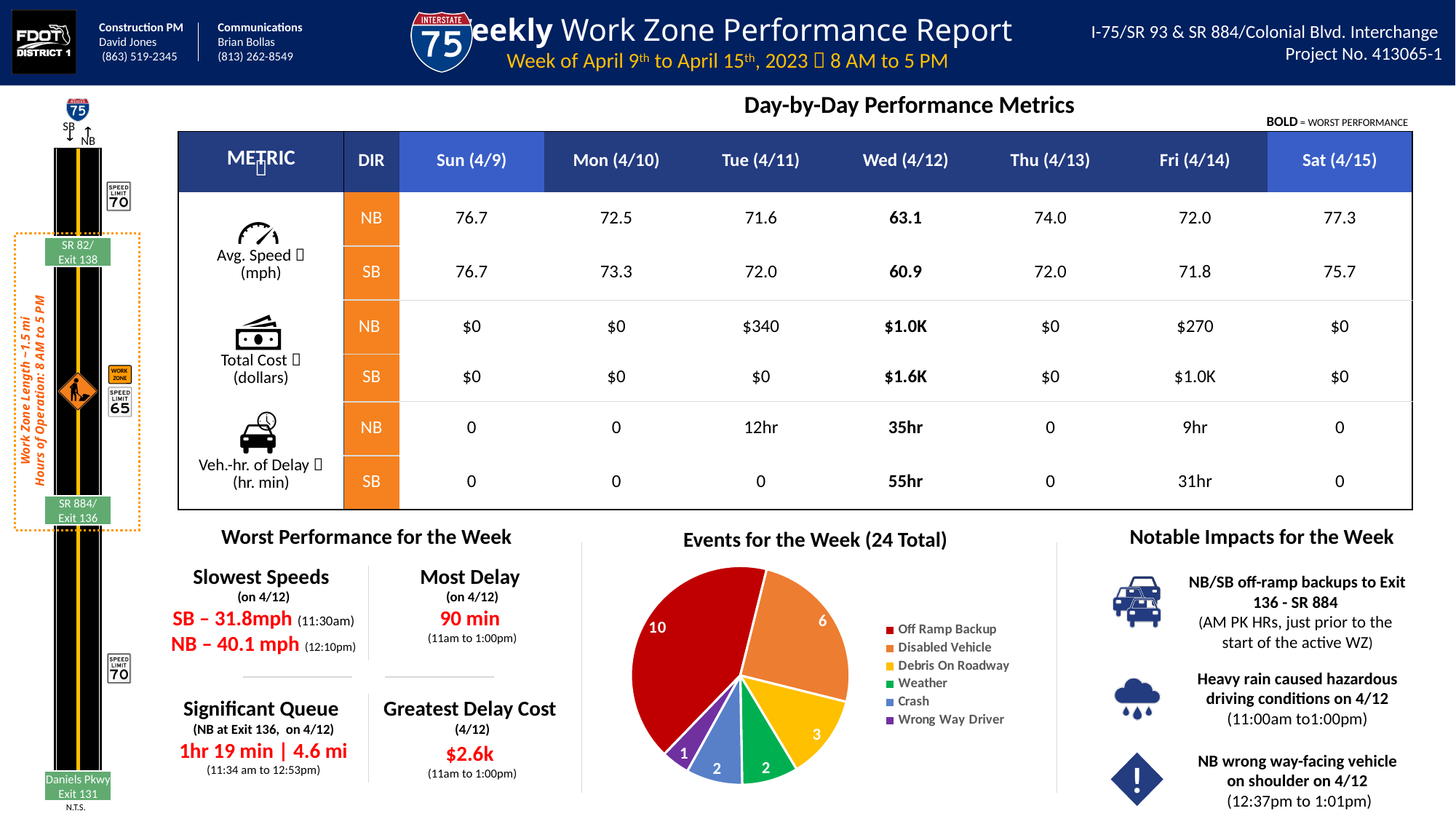
Which event category has the smallest slice in the Events for the Week pie chart? Wrong Way Driver In the Events for the Week pie chart, how many Wrong Way Driver events were there? 1 What is the total number of events shown in the Events for the Week pie chart? 24 How many event categories does the legend of the Events for the Week pie chart list? 6 What type of chart is used for Events for the Week? pie chart What share of the total events in the Events for the Week pie chart were Disabled Vehicles? 25% In the Events for the Week pie chart, how many Debris On Roadway events were there? 3 Which event category has the largest slice in the Events for the Week pie chart? Off Ramp Backup In the Events for the Week pie chart, how many more Off Ramp Backup events were there than Disabled Vehicle events? 4 In the Events for the Week pie chart, how many events were Disabled Vehicles? 6 In the Events for the Week pie chart, which is larger: Debris On Roadway or Crash? Debris On Roadway In the Events for the Week pie chart, how many events were Off Ramp Backups? 10